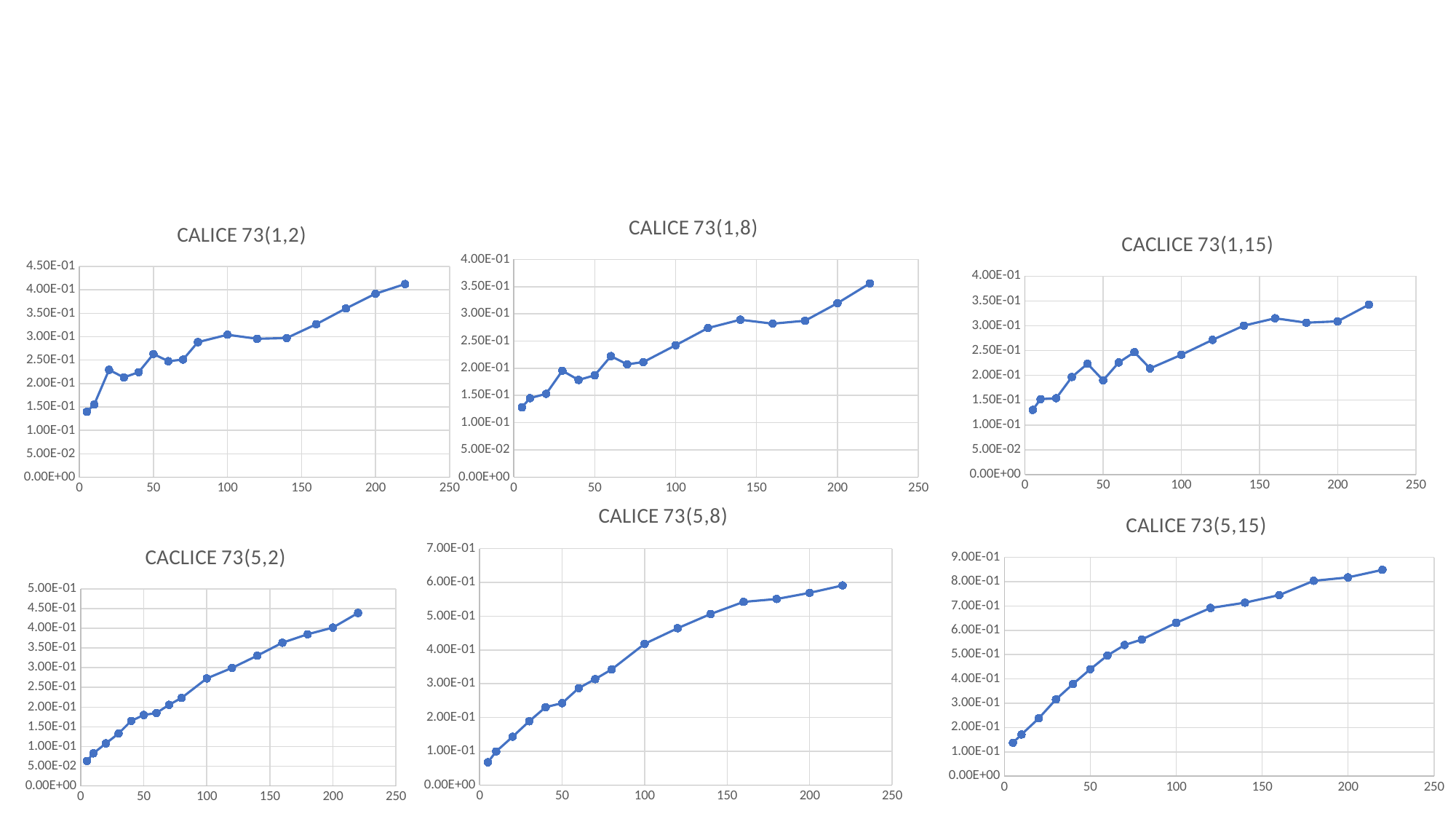
In the CACLICE 73(5,2) chart, at which x value is the plotted value lowest? 5 In the CALICE 73(5,15) chart, do the values rise or fall as x increases? rise What kind of chart is CALICE 73(1,2)? line chart How many data points are plotted in the CALICE 73(1,2) chart? 16 How many charts are shown on the slide? 6 In the CALICE 73(1,2) chart, at which x value is the plotted value highest? 220 In the CALICE 73(1,8) chart, is the value at x = 5 greater or less than 1.50E-01? less In the CALICE 73(1,2) chart, is the value at x = 160 greater or less than 3.00E-01? greater In the CACLICE 73(5,2) chart, is the value at x = 5 greater or less than 1.00E-01? less In the CALICE 73(5,8) chart, which is larger, the value at x = 50 or the value at x = 200? x = 200 What is the highest y-axis tick label on the CALICE 73(5,15) chart? 9.00E-01